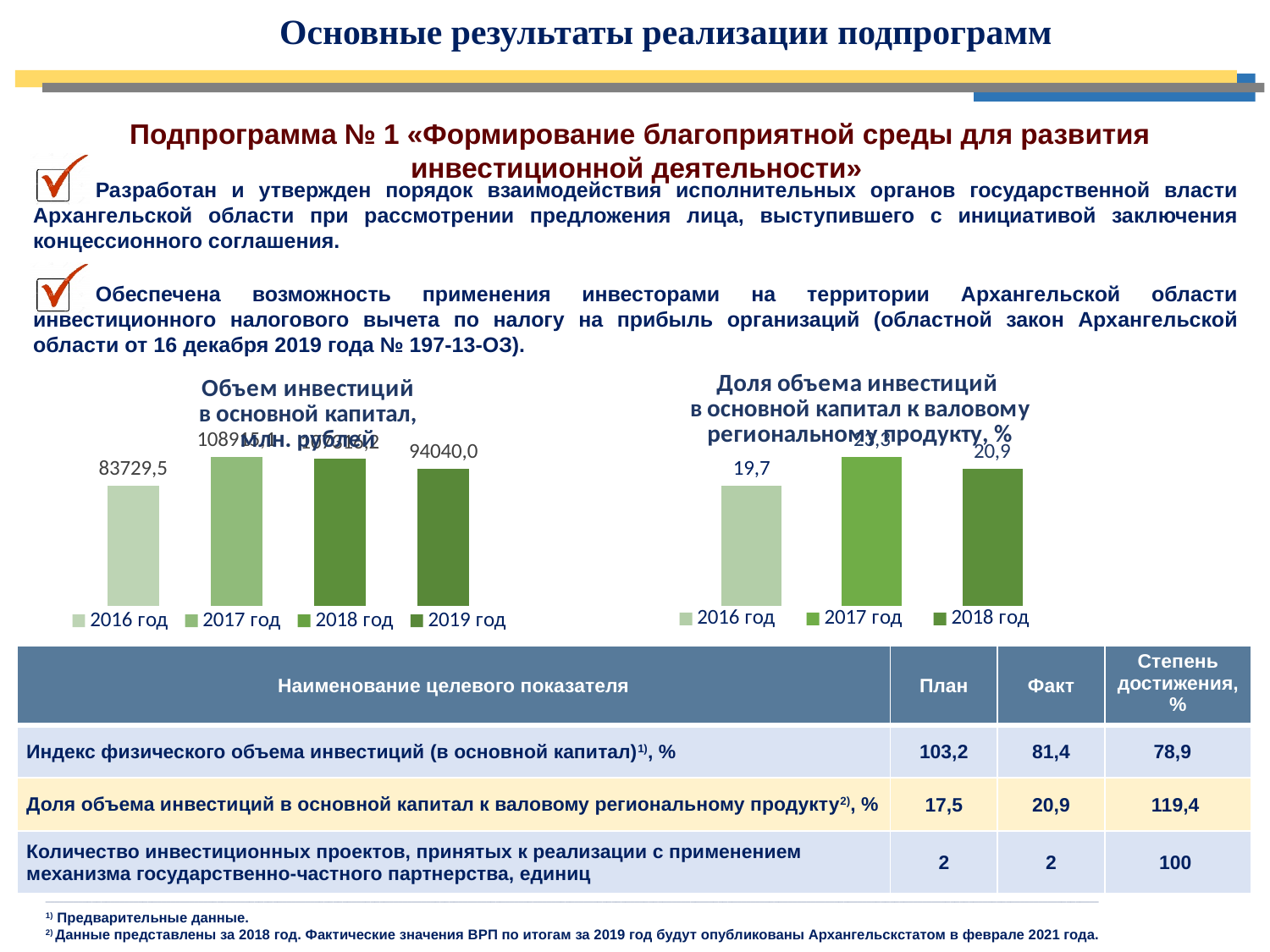
In the left chart «Объем инвестиций в основной капитал, млн. рублей», what is the value for 2019 год? 94040,0 In the left chart «Объем инвестиций в основной капитал, млн. рублей», which year has the lowest value? 2016 год In the right chart «Доля объема инвестиций в основной капитал к валовому региональному продукту, %», what is the difference between the values for 2018 год and 2016 год? 1,2 In the right chart «Доля объема инвестиций в основной капитал к валовому региональному продукту, %», what is the value for 2018 год? 20,9 How many years are listed in the legend of the left chart «Объем инвестиций в основной капитал, млн. рублей»? 4 What kind of chart is the left chart titled «Объем инвестиций в основной капитал, млн. рублей»? bar chart In the right chart «Доля объема инвестиций в основной капитал к валовому региональному продукту, %», what is the value for 2016 год? 19,7 In the left chart «Объем инвестиций в основной капитал, млн. рублей», which is larger: the value for 2016 год or 2019 год? 2019 год In the right chart «Доля объема инвестиций в основной капитал к валовому региональному продукту, %», which year has the highest value? 2017 год How many bars are shown in the right chart «Доля объема инвестиций в основной капитал к валовому региональному продукту, %»? 3 In the left chart «Объем инвестиций в основной капитал, млн. рублей», what is the difference between the values for 2019 год and 2016 год? 10310,5 In the left chart «Объем инвестиций в основной капитал, млн. рублей», what is the value for 2016 год? 83729,5